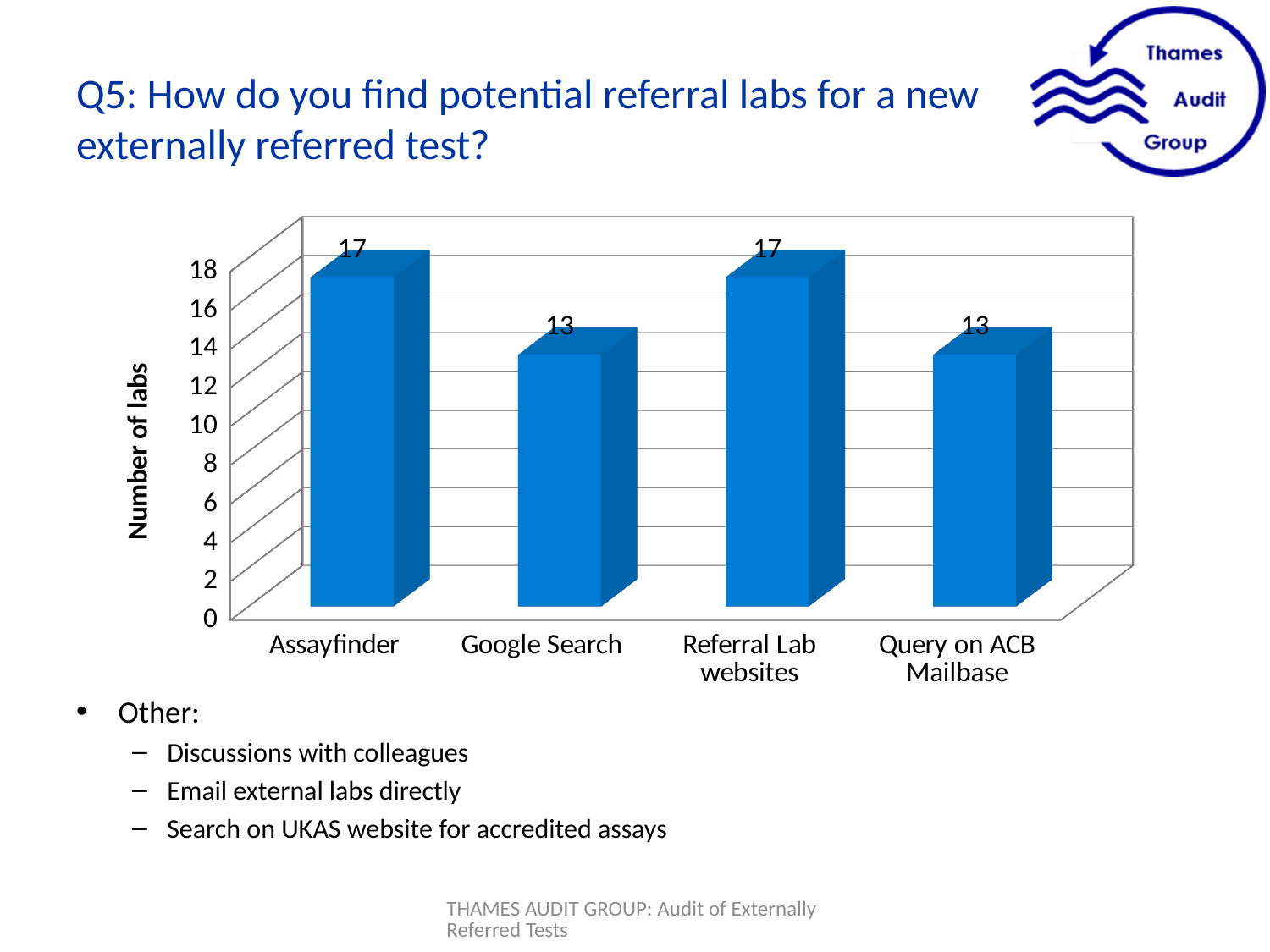
What is the value for Query on ACB Mailbase? 13 Which categories share the lowest value in the chart? Google Search and Query on ACB Mailbase Which is larger, the value for Referral Lab websites or the value for Query on ACB Mailbase? Referral Lab websites What is the difference between the values for Assayfinder and Google Search? 4 How many labs use Referral Lab websites? 17 Is the value for Google Search greater or less than 10? greater What is the label of the vertical axis of the chart? Number of labs How many labs use Assayfinder to find potential referral labs? 17 What is the value for Google Search? 13 What kind of chart is shown on the slide? bar chart What is the total of the values for Assayfinder and Referral Lab websites? 34 How many categories are shown on the x axis of the chart? 4